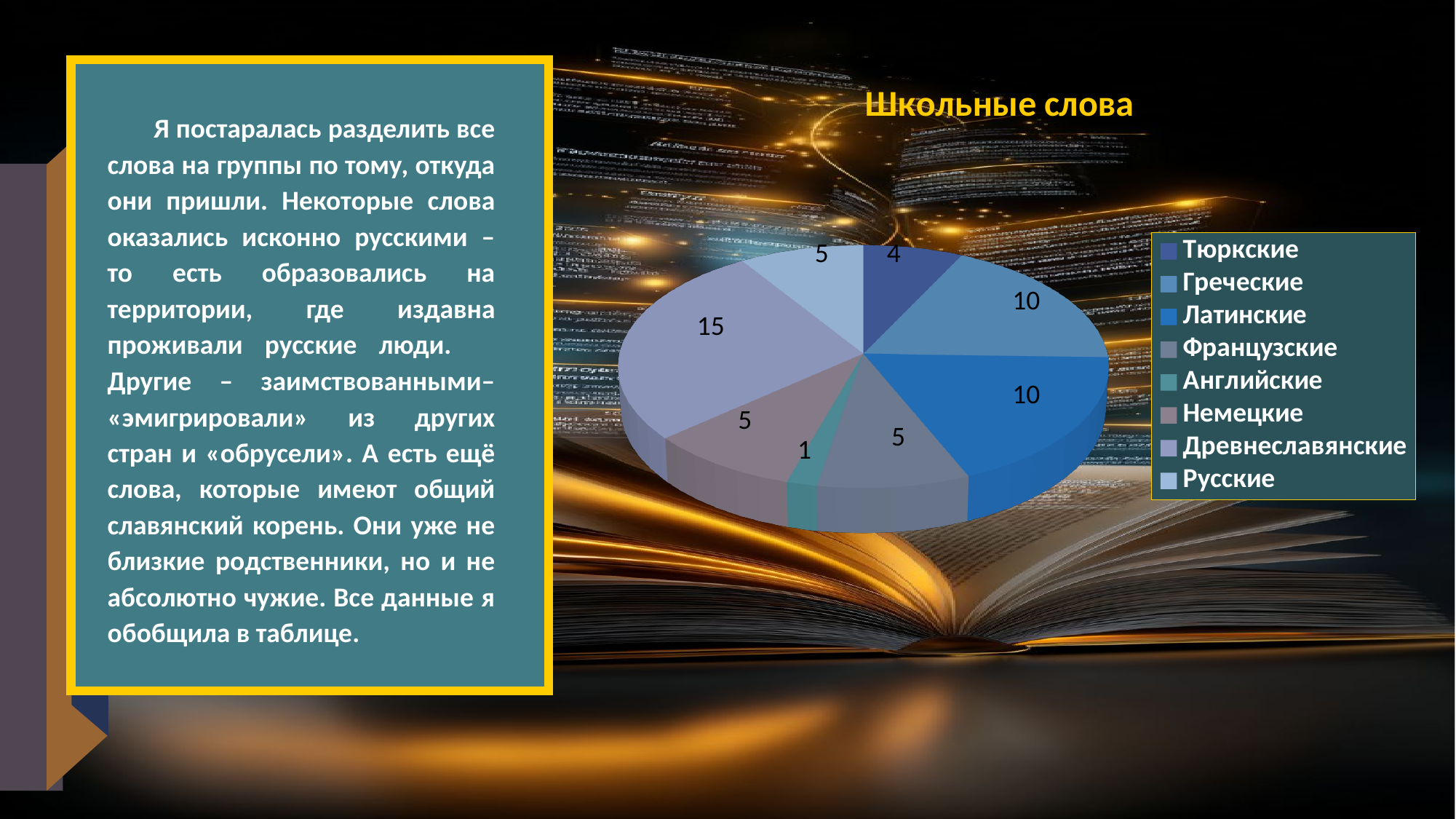
What kind of chart is shown on the slide? pie chart What is the value for Древнеславянские? 15 Which category has the largest slice? Древнеславянские What is the value for Латинские? 10 What is the value for Тюркские? 4 How many categories does the pie chart have? 8 What is the title of the chart? Школьные слова Which is larger, the value for Греческие or the value for Русские? Греческие What is the value for Английские? 1 What is the difference between the values for Древнеславянские and Тюркские? 11 Which category has the smallest slice? Английские How many entries does the legend list? 8